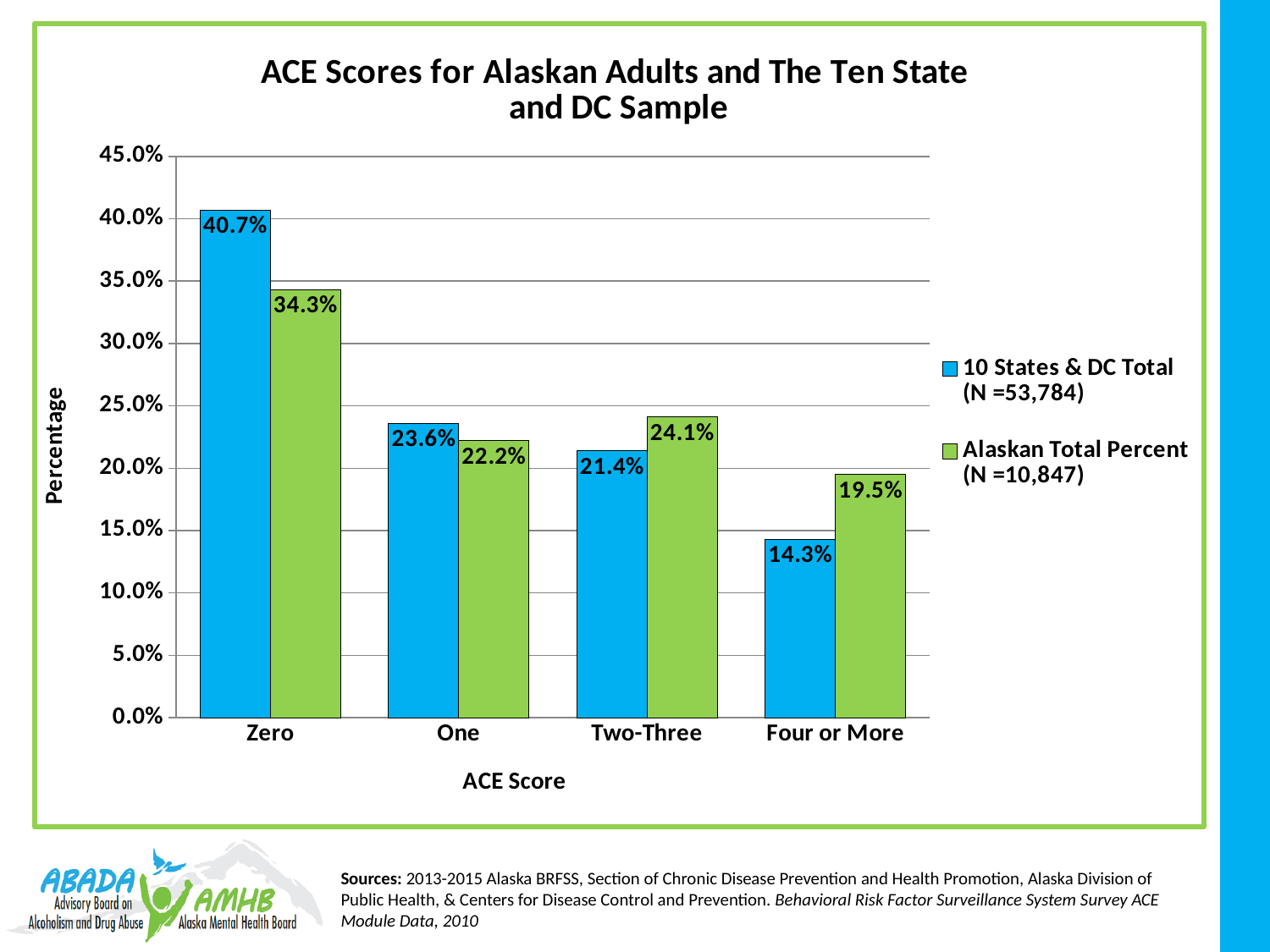
What is the difference between the 10 States & DC Total and the Alaskan Total Percent for an ACE score of Zero? 6.4% For an ACE score of Four or More, which is larger: the 10 States & DC Total or the Alaskan Total Percent? Alaskan Total Percent What is the Alaskan Total Percent for an ACE score of Two-Three? 24.1% What kind of chart is shown on the slide? Bar chart What is the label of the y axis? Percentage How many series does the legend list? 2 Which ACE score category has the highest value for the 10 States & DC Total series? Zero For an ACE score of One, which is larger: the 10 States & DC Total or the Alaskan Total Percent? 10 States & DC Total Which ACE score category has the lowest Alaskan Total Percent? Four or More How many ACE score categories are shown on the x axis? 4 What is the value for the 10 States & DC Total series at an ACE score of Zero? 40.7% What is the Alaskan Total Percent for an ACE score of Four or More? 19.5%